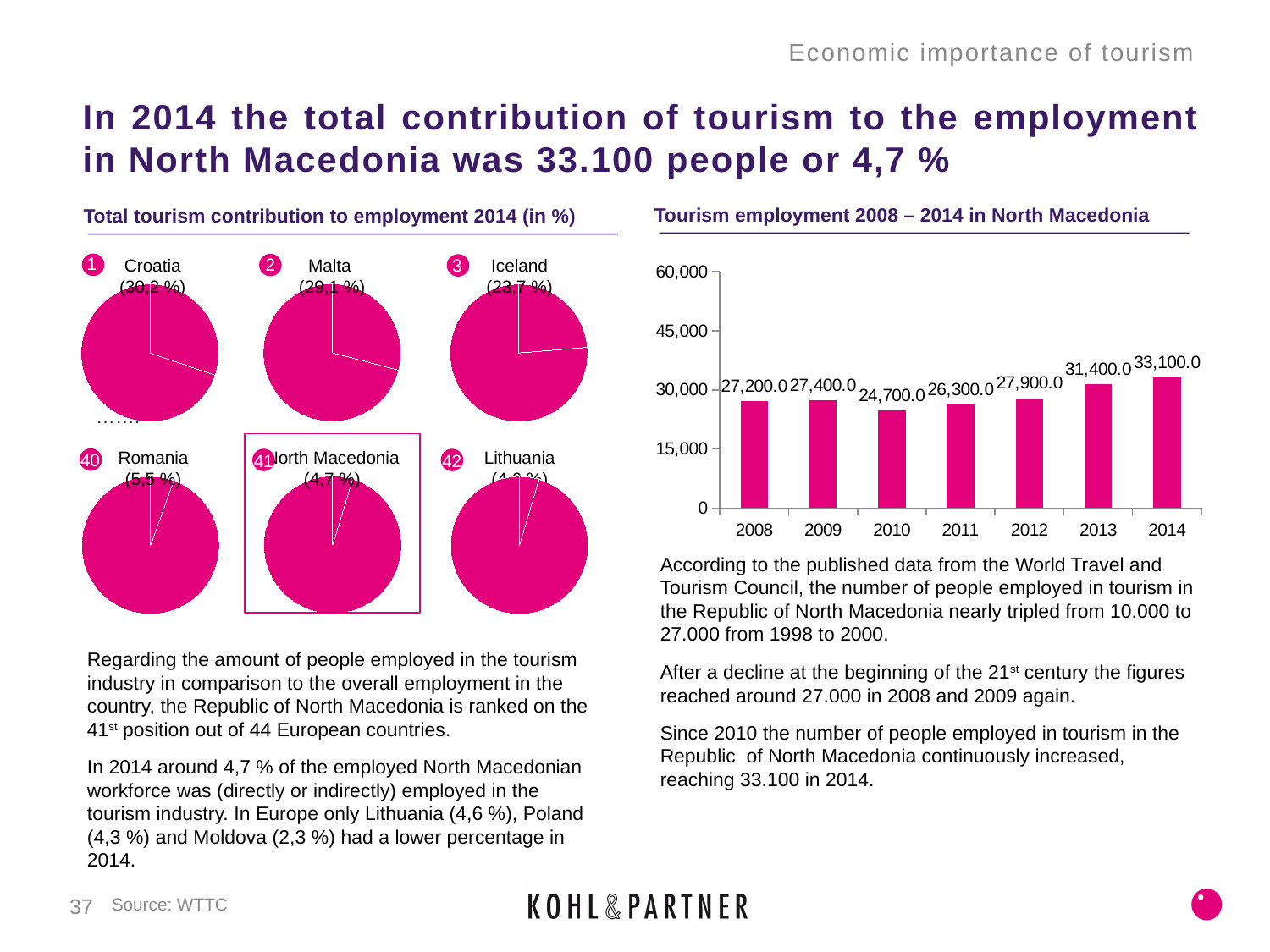
In the 'Tourism employment 2008 – 2014 in North Macedonia' chart, which year has the lowest value? 2010 In the 'Tourism employment 2008 – 2014 in North Macedonia' chart, which is larger, the value for 2011 or the value for 2012? 2012 How many years are shown on the x axis of the 'Tourism employment 2008 – 2014 in North Macedonia' chart? 7 In the 'Total tourism contribution to employment 2014 (in %)' pie charts, what share is shown for North Macedonia? 4,7 % What kind of chart is 'Tourism employment 2008 – 2014 in North Macedonia'? bar chart In the 'Tourism employment 2008 – 2014 in North Macedonia' chart, do the values rise or fall from 2010 to 2014? rise In the 'Tourism employment 2008 – 2014 in North Macedonia' chart, what is the difference between the 2014 and 2008 values? 5,900.0 In the 'Tourism employment 2008 – 2014 in North Macedonia' chart, is the value for 2014 greater or less than 30,000? greater In the 'Total tourism contribution to employment 2014 (in %)' pie charts, what share is shown for Croatia? 30,2 % In the 'Tourism employment 2008 – 2014 in North Macedonia' chart, what is the value for 2010? 24,700.0 In the 'Tourism employment 2008 – 2014 in North Macedonia' chart, what is the value for 2013? 31,400.0 In the 'Tourism employment 2008 – 2014 in North Macedonia' chart, which year has the highest value? 2014